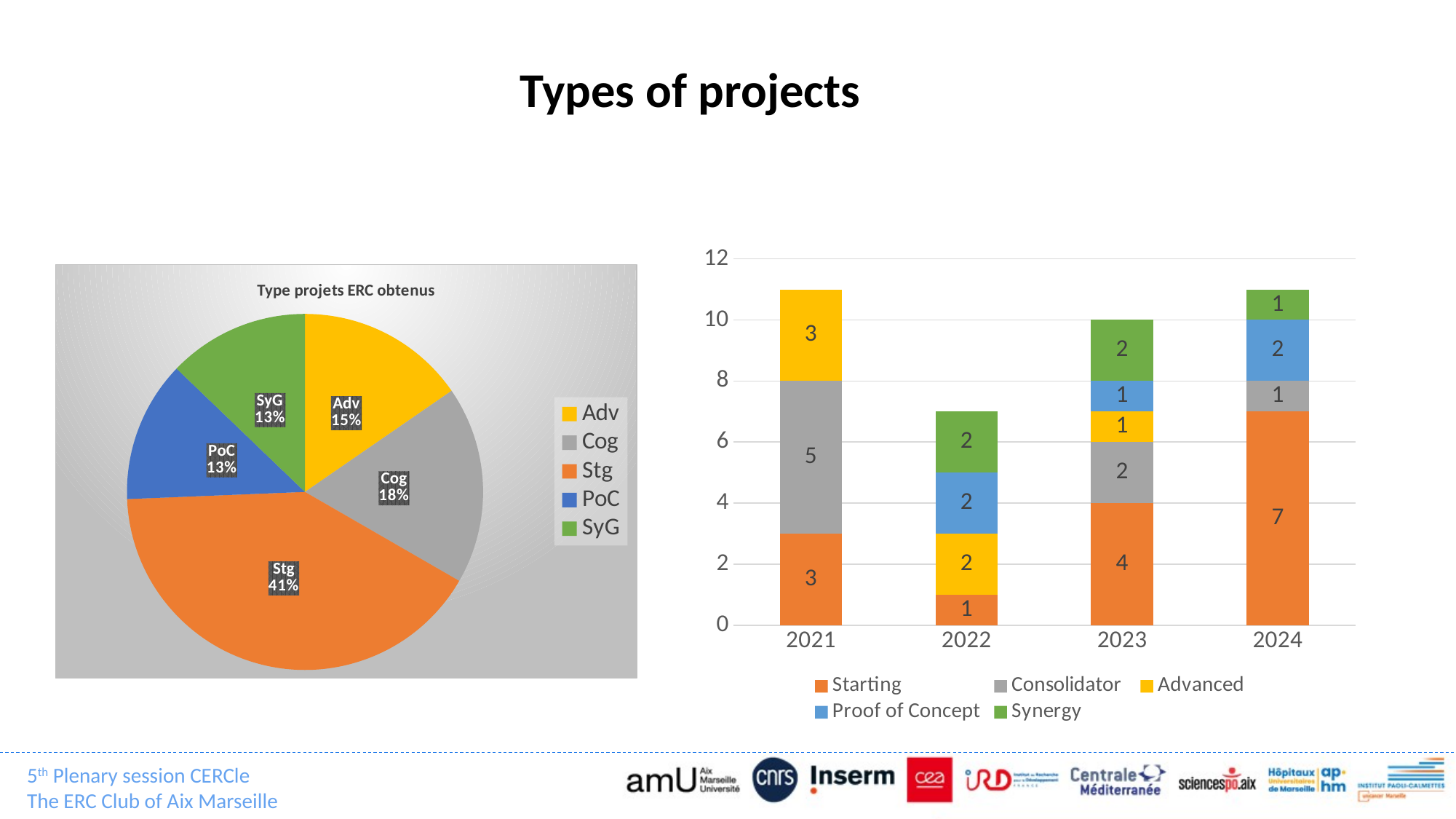
In the pie chart 'Type projets ERC obtenus', how many categories are shown? 5 In the pie chart 'Type projets ERC obtenus', what is the difference between the Adv share and the PoC share? 2% In the pie chart 'Type projets ERC obtenus', what is the share for Cog? 18% In the stacked bar chart on the right, what is the Consolidator value for 2021? 5 In the pie chart 'Type projets ERC obtenus', what share does Stg have? 41% In the stacked bar chart on the right, what is the total of the 2023 bar? 10 In the stacked bar chart on the right, is the Starting value larger in 2023 or in 2024? 2024 In the stacked bar chart on the right, how many series does the legend list? 5 In the stacked bar chart on the right, which year has the lowest total? 2022 What kind of chart is the chart on the right of the slide? Stacked bar chart In the stacked bar chart on the right, what is the Starting value for 2024? 7 In the pie chart 'Type projets ERC obtenus', which category has the largest share? Stg